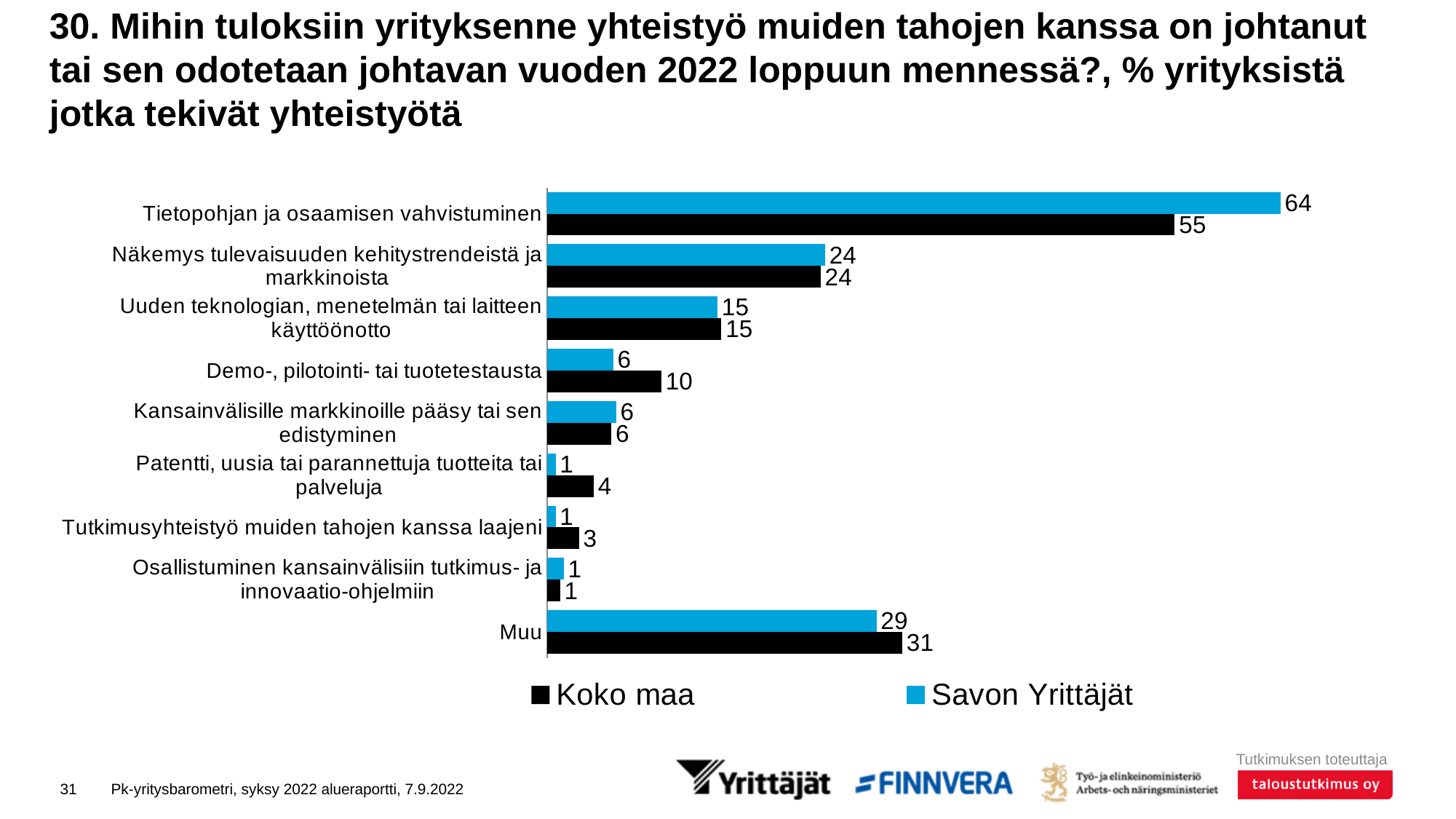
What is the value for Koko maa for "Muu"? 31 How many categories are shown on the chart? 9 What kind of chart is shown on the slide? Bar chart How many series does the legend list? 2 What is the difference between the Savon Yrittäjät and Koko maa values for "Tietopohjan ja osaamisen vahvistuminen"? 9 Which category has the lowest value for Koko maa? Osallistuminen kansainvälisiin tutkimus- ja innovaatio-ohjelmiin What is the value for Koko maa for "Demo-, pilotointi- tai tuotetestausta"? 10 What is the value for Savon Yrittäjät for "Tietopohjan ja osaamisen vahvistuminen"? 64 Which colour represents Savon Yrittäjät in the chart? Blue Which category has the highest value for Koko maa? Tietopohjan ja osaamisen vahvistuminen For "Muu", which series has the larger value, Koko maa or Savon Yrittäjät? Koko maa For "Patentti, uusia tai parannettuja tuotteita tai palveluja", which series has the larger value, Koko maa or Savon Yrittäjät? Koko maa